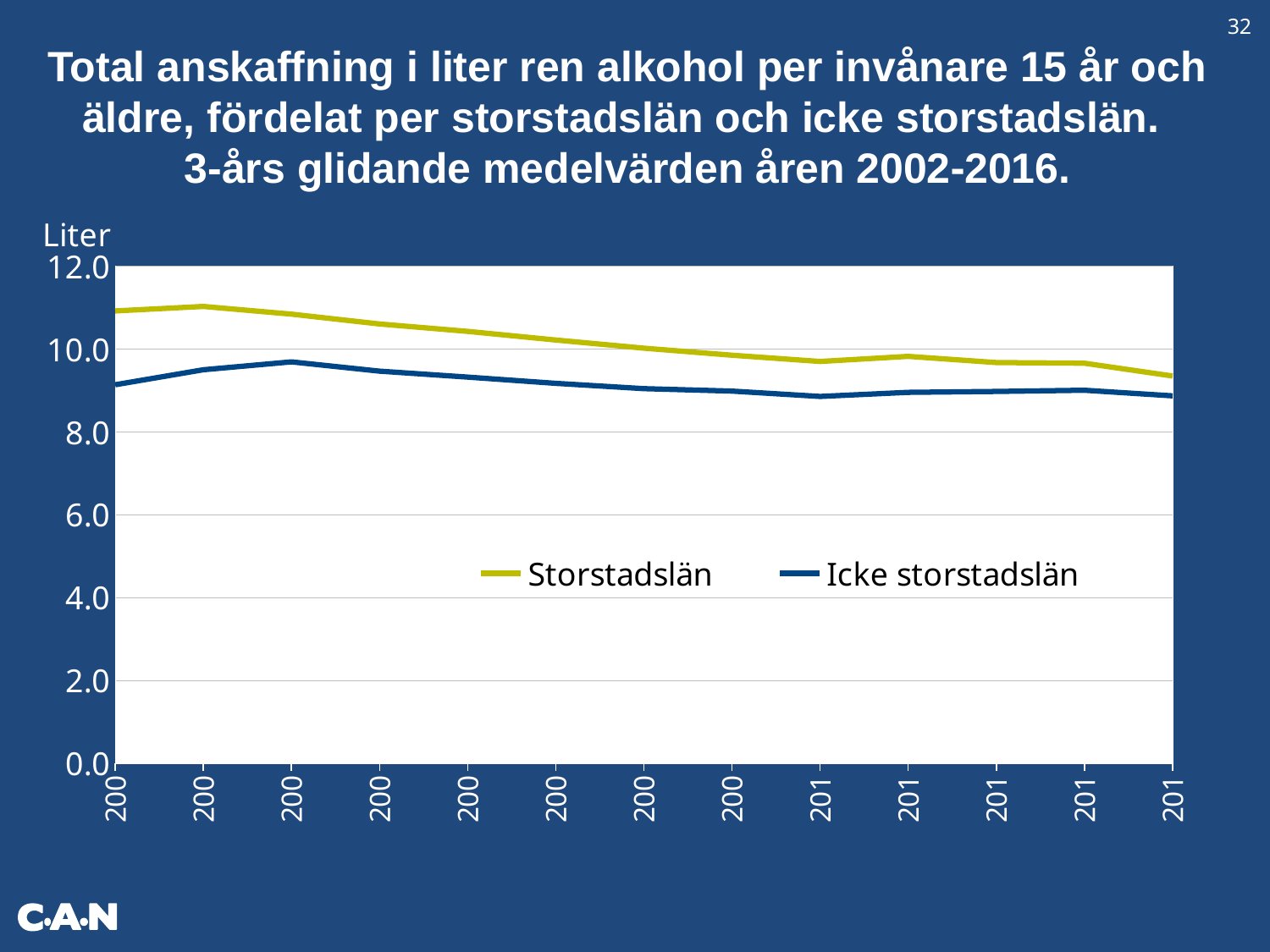
Which series is plotted higher across the whole chart, Storstadslän or Icke storstadslän? Storstadslän How many data points does each line have? 13 Which colour is used for the Icke storstadslän line? Blue Is the value for Icke storstadslän at the leftmost point greater or less than 10.0? less What unit label is shown above the vertical axis? Liter What kind of chart is shown on the slide? Line chart Does the Icke storstadslän line generally rise or fall from left to right? Fall Is the value for Storstadslän at the leftmost point greater or less than 10.0? greater Is the value for Storstadslän at the rightmost point greater or less than 10.0? less How many series does the legend list? 2 Does the Storstadslän line generally rise or fall from left to right? Fall